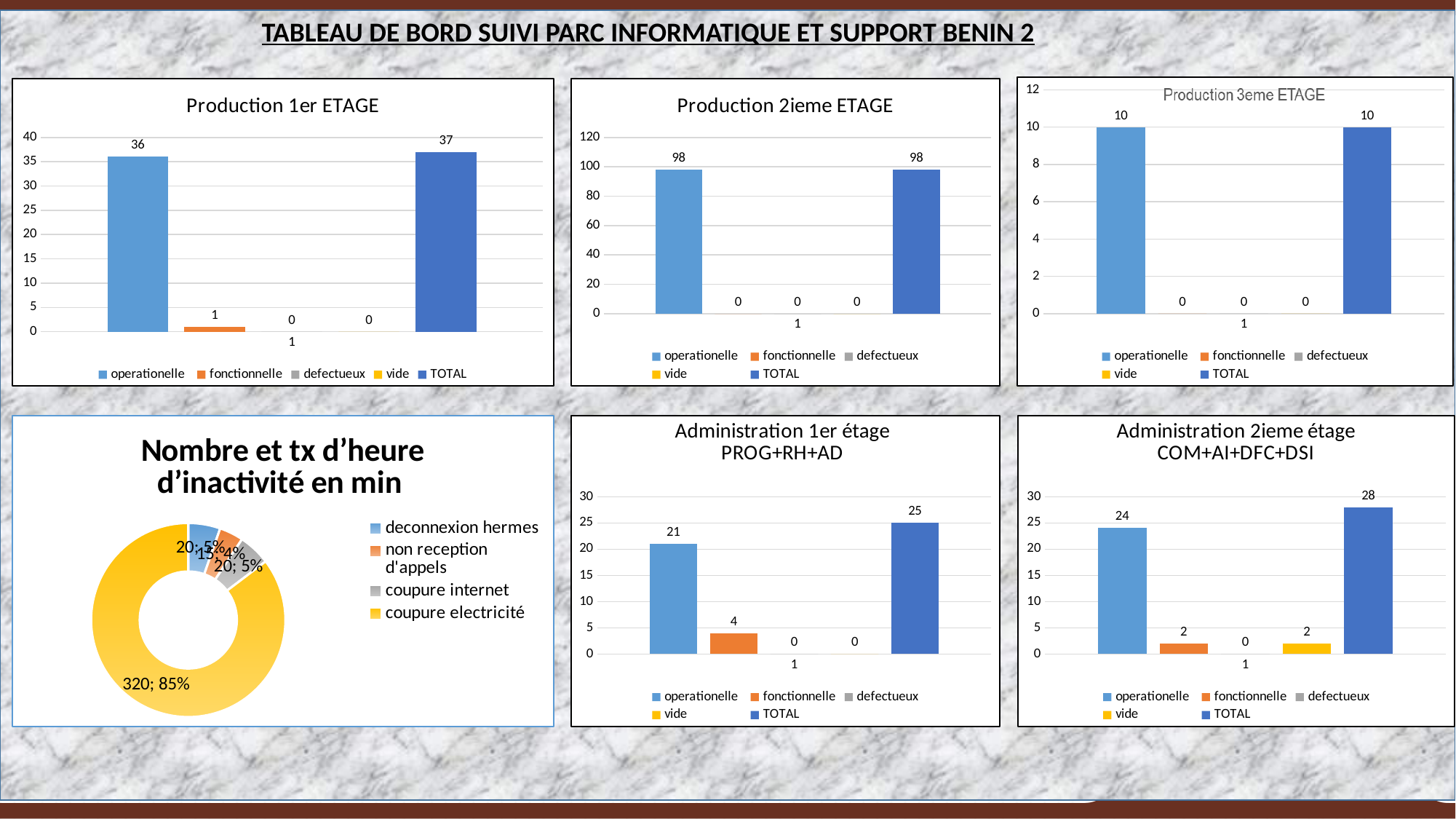
In the 'Production 1er ETAGE' chart, what is the value for operationelle? 36 How many series does the legend of the 'Production 2ieme ETAGE' chart list? 5 In the 'Administration 2ieme étage COM+AI+DFC+DSI' chart, what is the value for vide? 2 In the 'Production 2ieme ETAGE' chart, what is the value for operationelle? 98 In the 'Nombre et tx d'heure d'inactivité en min' chart, what share does coupure electricité have? 85% In the 'Production 1er ETAGE' chart, what is the value for TOTAL? 37 In the 'Administration 1er étage PROG+RH+AD' chart, what is the difference between TOTAL and operationelle? 4 In the 'Administration 1er étage PROG+RH+AD' chart, what is the value for fonctionnelle? 4 In the 'Administration 2ieme étage COM+AI+DFC+DSI' chart, which series has the highest value? TOTAL In the 'Production 3eme ETAGE' chart, what is the value for TOTAL? 10 In the 'Nombre et tx d'heure d'inactivité en min' chart, what is the value for non reception d'appels? 15 What kind of chart is 'Nombre et tx d'heure d'inactivité en min'? Doughnut chart